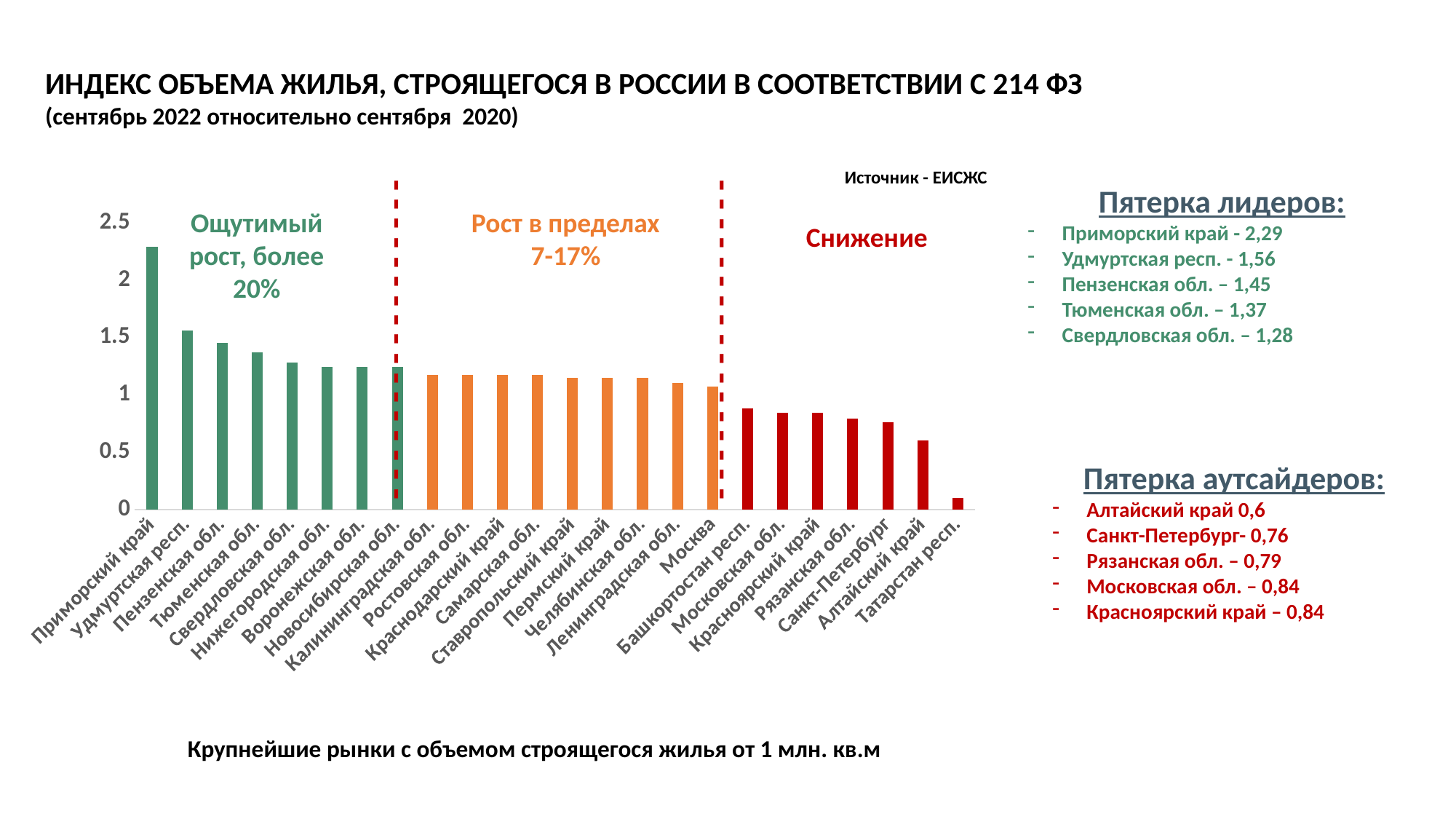
What is the index value for Санкт-Петербург? 0,76 Do the bar values rise or fall from left to right along the x axis? Fall What kind of chart is shown on the slide? Bar chart Which region has the highest index value on the chart? Приморский край Is the value for Башкортостан респ. greater or less than 1? less What source is cited for the chart data? ЕИСЖС What is the index value for Приморский край? 2,29 What is the index value for Свердловская обл.? 1,28 How many regions are plotted on the chart? 24 What is the difference between the index values of Приморский край and Удмуртская респ.? 0,73 Which has a larger index value, Пензенская обл. or Тюменская обл.? Пензенская обл. Which region has the lowest bar on the chart? Татарстан респ.